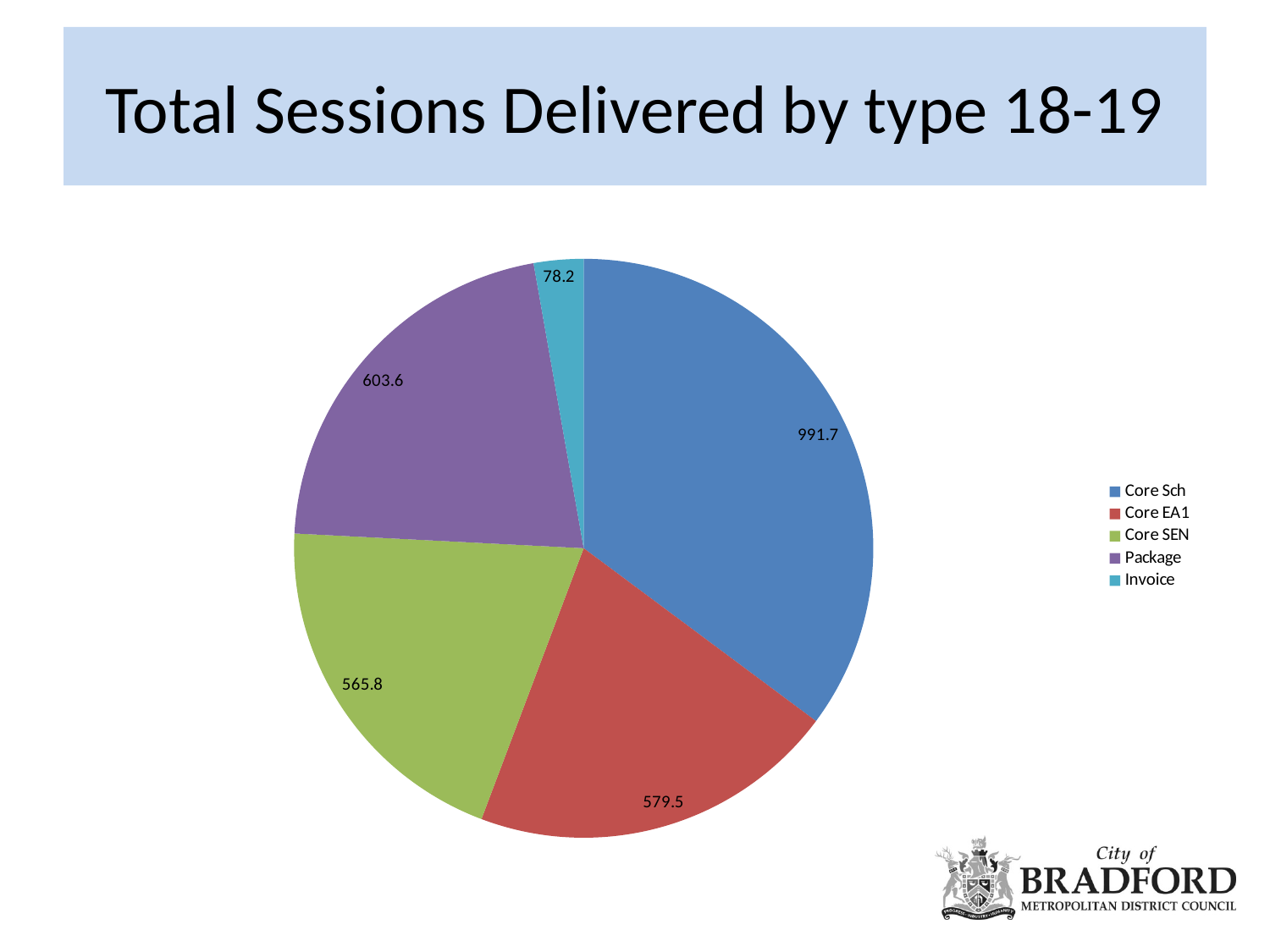
What type of chart is shown on the slide? pie chart What is the difference between the values for Core Sch and Package? 388.1 Which is larger, the value for Package or the value for Core EA1? Package Which category has the largest slice of the pie? Core Sch How many categories does the pie chart have? 5 What is the title of the chart on the slide? Total Sessions Delivered by type 18-19 Which colour represents Core SEN in the legend? green What is the difference between the values for Core EA1 and Core SEN? 13.7 What is the value for Package? 603.6 What is the value for Core Sch? 991.7 Which category has the smallest slice of the pie? Invoice What is the value for Invoice? 78.2